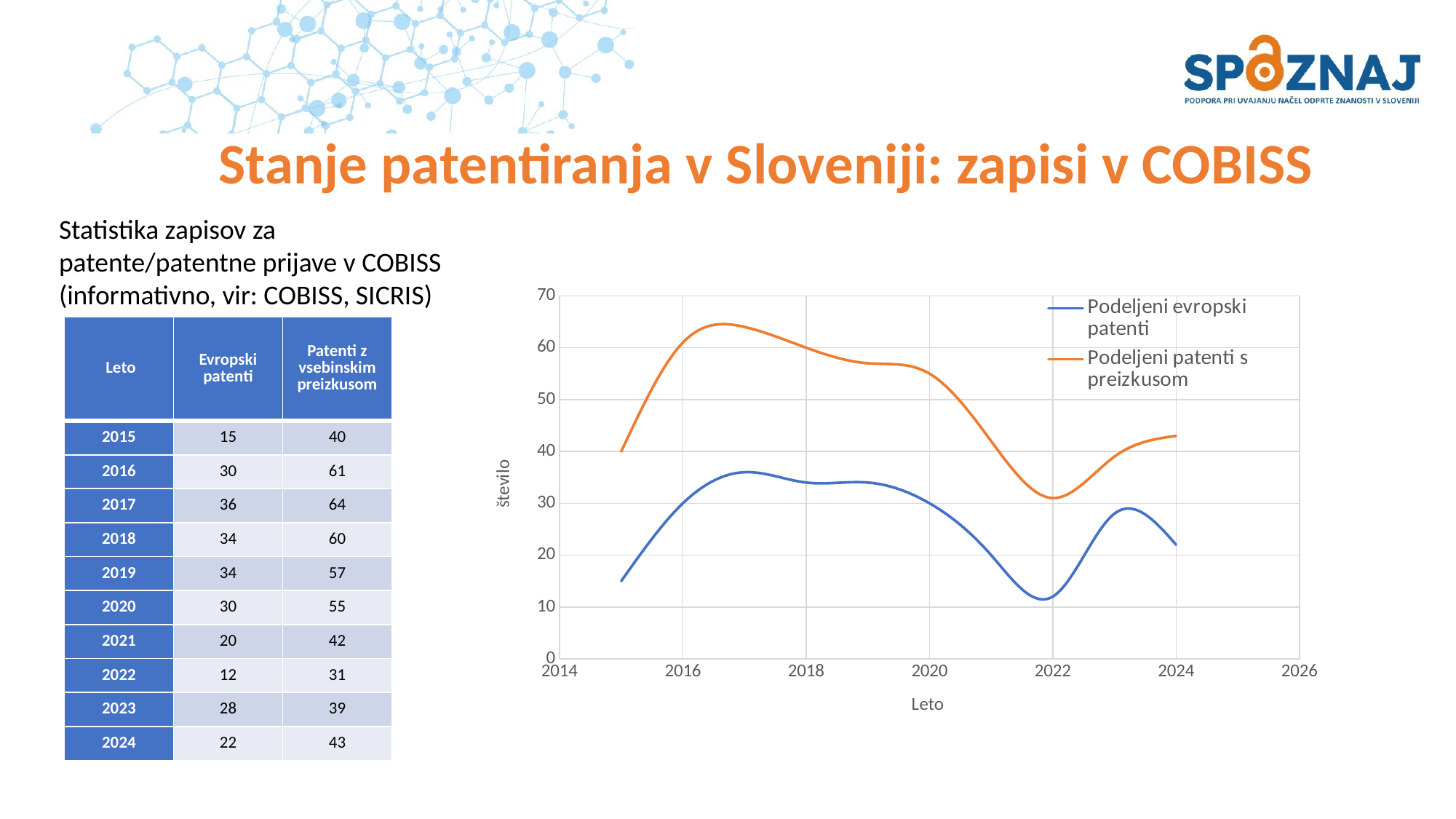
What is the value of Podeljeni evropski patenti in 2017? 36 What kind of chart is shown on the slide? line chart What is the value of Podeljeni patenti s preizkusom in 2022? 31 What is the label of the chart's vertical axis? število What is the difference between Podeljeni patenti s preizkusom and Podeljeni evropski patenti in 2016? 31 In which year is Podeljeni evropski patenti lowest? 2022 Is the value for Podeljeni evropski patenti in 2022 greater or less than 20? less What are the two series named in the chart legend? Podeljeni evropski patenti; Podeljeni patenti s preizkusom How many series does the chart legend list? 2 Which series has the higher value in 2020? Podeljeni patenti s preizkusom In which year is Podeljeni patenti s preizkusom highest? 2017 Do the values for Podeljeni evropski patenti rise or fall from 2019 to 2022? fall